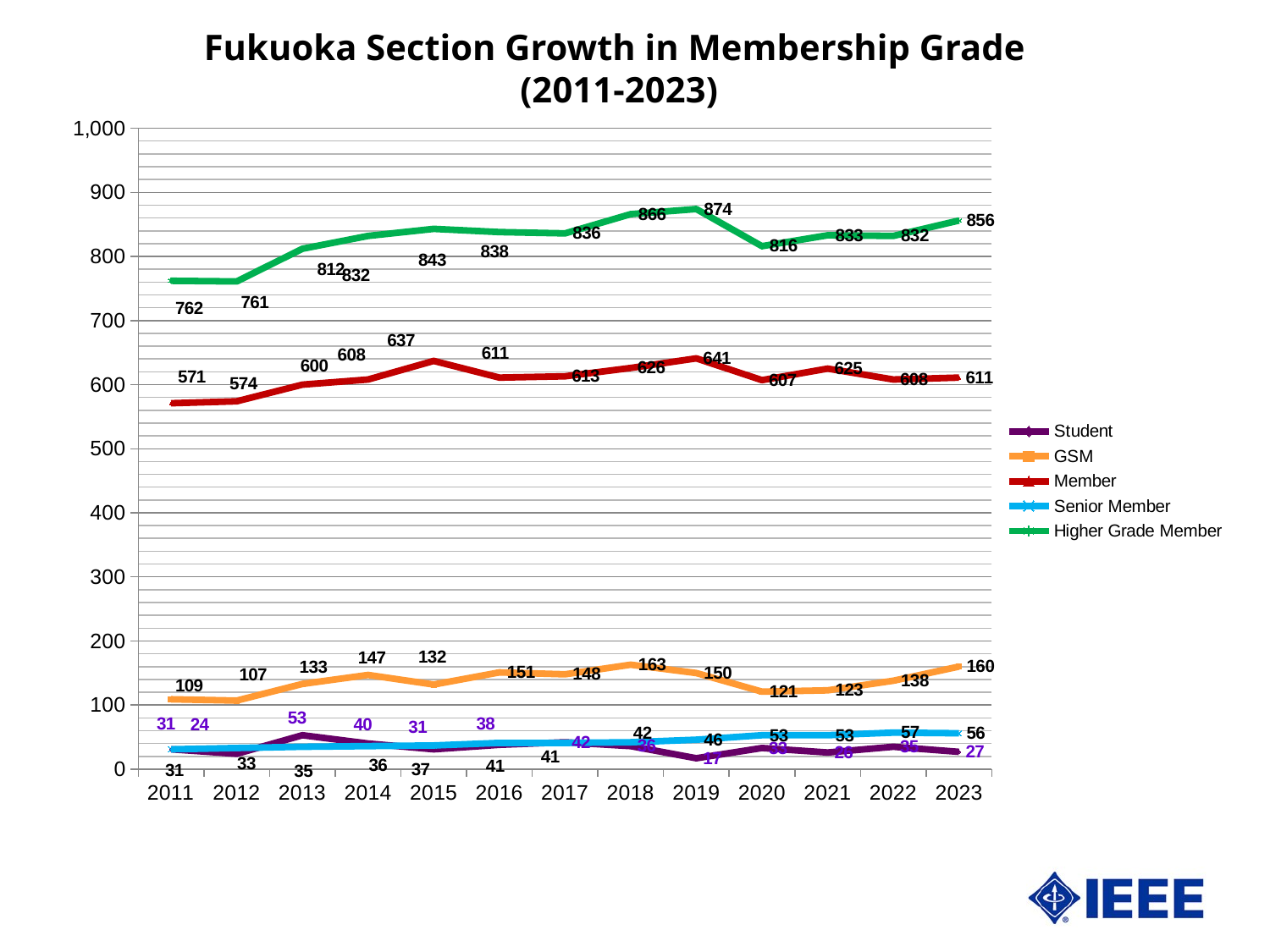
Does the Higher Grade Member line rise or fall from 2011 to 2015? Rise By how much did the Higher Grade Member value increase from 2011 to 2023? 94 How many years are plotted along the x axis? 13 In which year is the Higher Grade Member value highest? 2019 What is the Senior Member value in 2023? 56 Which year has the larger Member value, 2019 or 2020? 2019 What is the Member value in 2015? 637 In which year is the GSM value lowest? 2012 What kind of chart is shown on the slide? Line chart How many series does the legend list? 5 What is the GSM value in 2018? 163 What is the Higher Grade Member value in 2019? 874